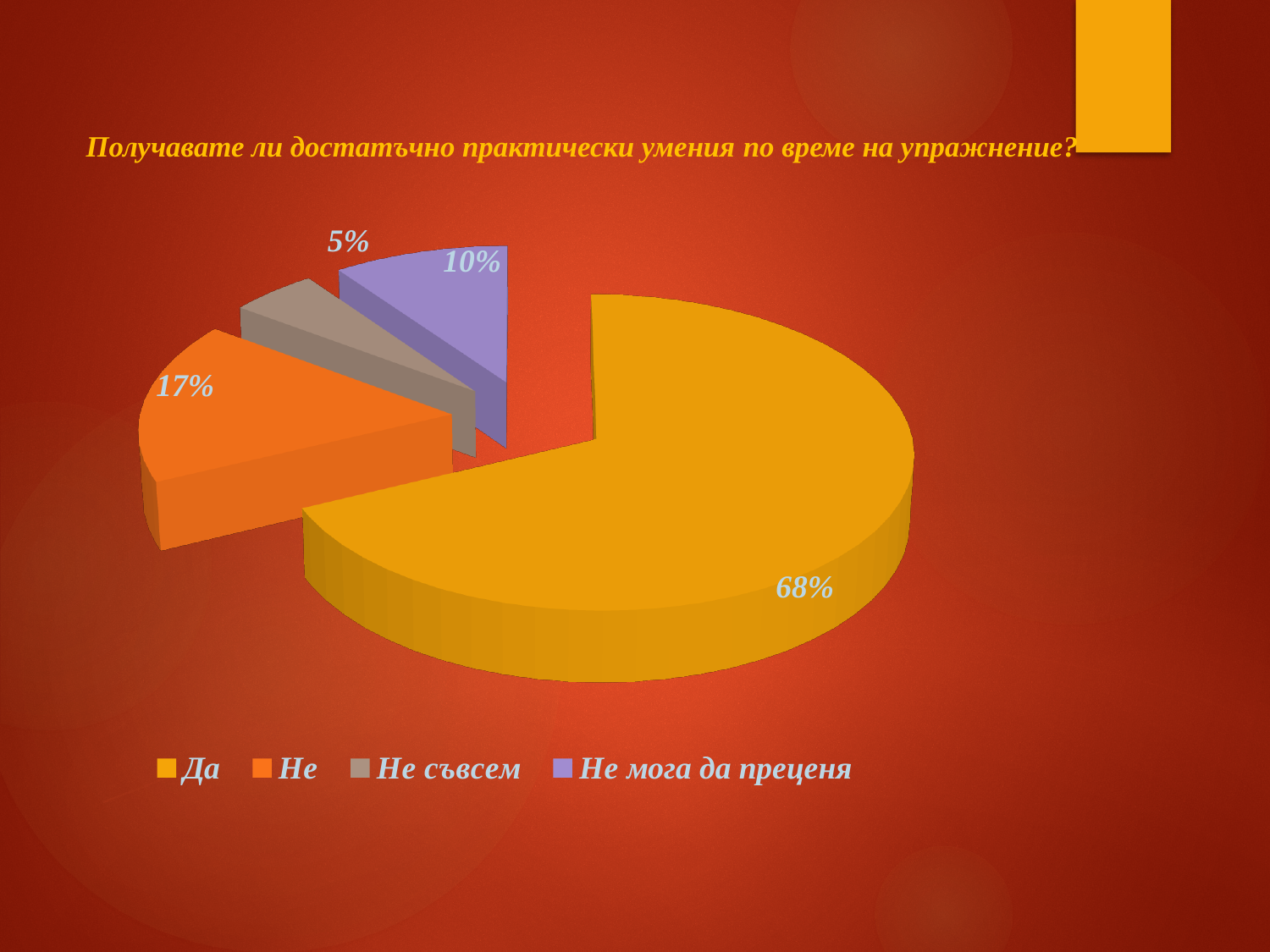
Which is larger, the share for "Не" or the share for "Не мога да преценя"? Не What is the title of the chart? Получавате ли достатъчно практически умения по време на упражнение? What percentage of respondents answered "Да"? 68% What colour is the slice for "Не мога да преценя"? Purple How many slices does the pie chart have? 4 What percentage of respondents answered "Не съвсем"? 5% What is the difference in percentage points between "Да" and "Не"? 51 Which answer has the smallest share of the pie? Не съвсем What percentage of respondents answered "Не мога да преценя"? 10% What type of chart is shown on the slide? Pie chart What percentage of respondents answered "Не"? 17% Which answer has the largest share of the pie? Да